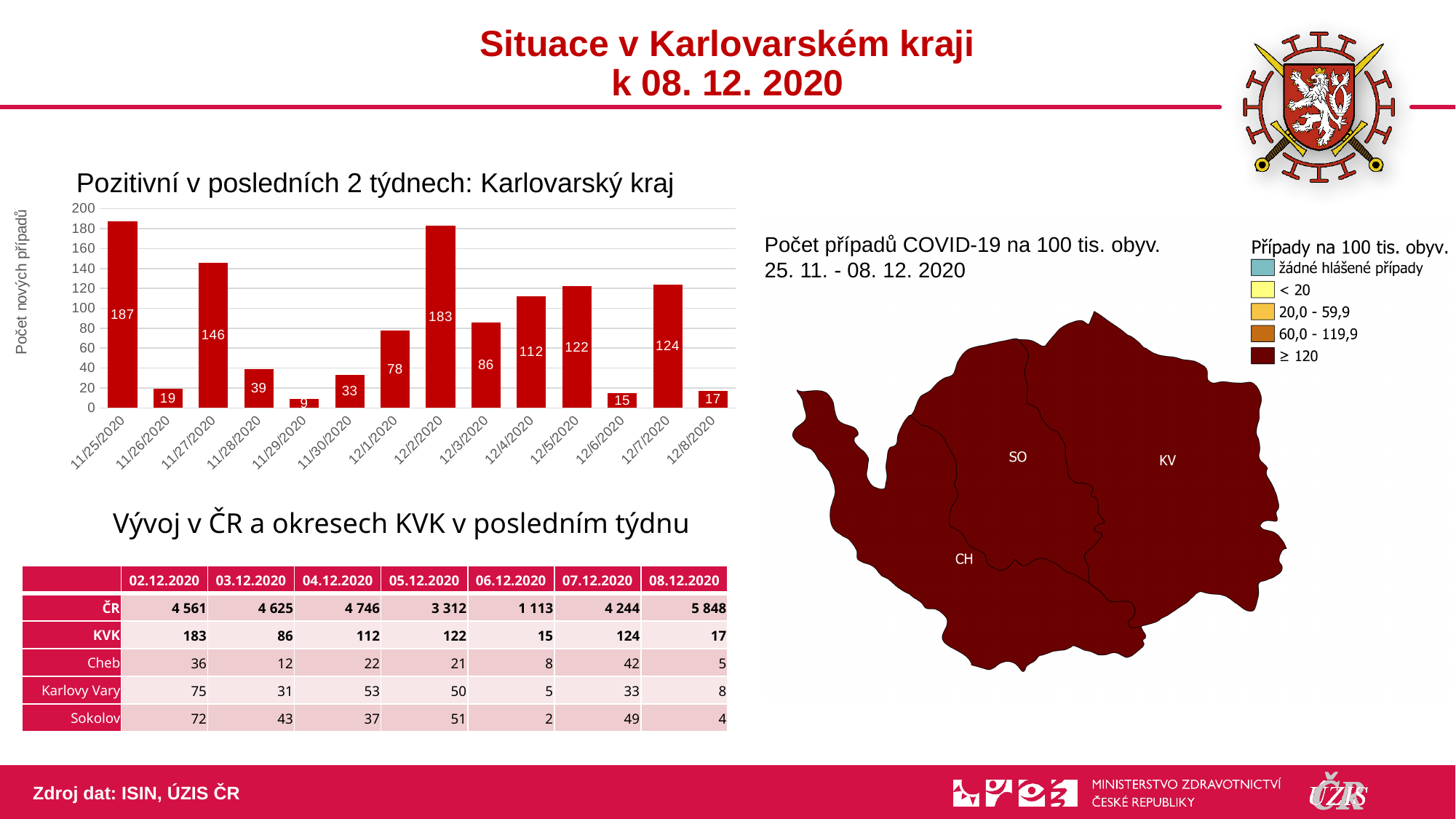
What is the value for 12/2/2020 in the bar chart? 183 Which date has the highest value in the bar chart? 11/25/2020 What is the value for 11/29/2020 in the bar chart? 9 Which is larger in the bar chart, the value for 12/4/2020 or 12/5/2020? 12/5/2020 How many dates are shown on the x axis of the bar chart? 14 Is the value for 11/27/2020 in the bar chart greater or less than 140? greater What is the value for 11/25/2020 in the bar chart? 187 What is the title of the bar chart? Pozitivní v posledních 2 týdnech: Karlovarský kraj What kind of chart is used to show the positive cases in the last 2 weeks? bar chart What is the y-axis label of the bar chart? Počet nových případů What is the difference between the values for 12/7/2020 and 12/8/2020 in the bar chart? 107 Which date has the lowest value in the bar chart? 11/29/2020